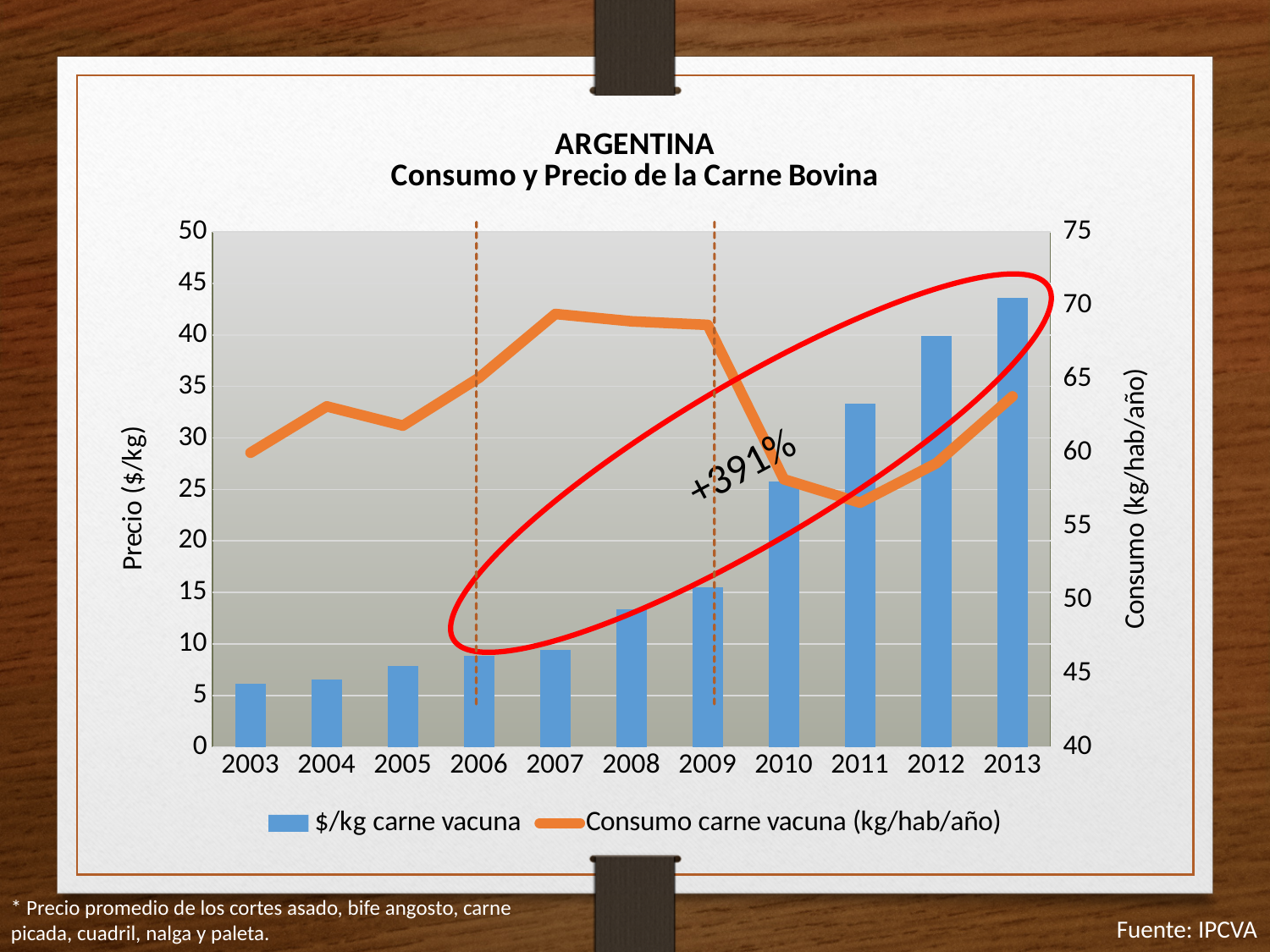
Is the $/kg carne vacuna value for 2012 greater or less than 35? greater What kind of chart is shown on the slide? Combined bar and line chart In which year is the bar for $/kg carne vacuna the lowest? 2003 Do the $/kg carne vacuna bars rise or fall from 2003 to 2013? Rise How many years are shown on the x axis of the chart? 11 Is the $/kg carne vacuna value for 2008 greater or less than 15? less Is the Consumo carne vacuna value for 2010 greater or less than 60? less How many series does the legend list? 2 What percentage change is annotated inside the red ellipse on the chart? +391% In which year does the Consumo carne vacuna line reach its lowest point? 2011 In which year does the Consumo carne vacuna line reach its highest point? 2007 In which year is the bar for $/kg carne vacuna the highest? 2013